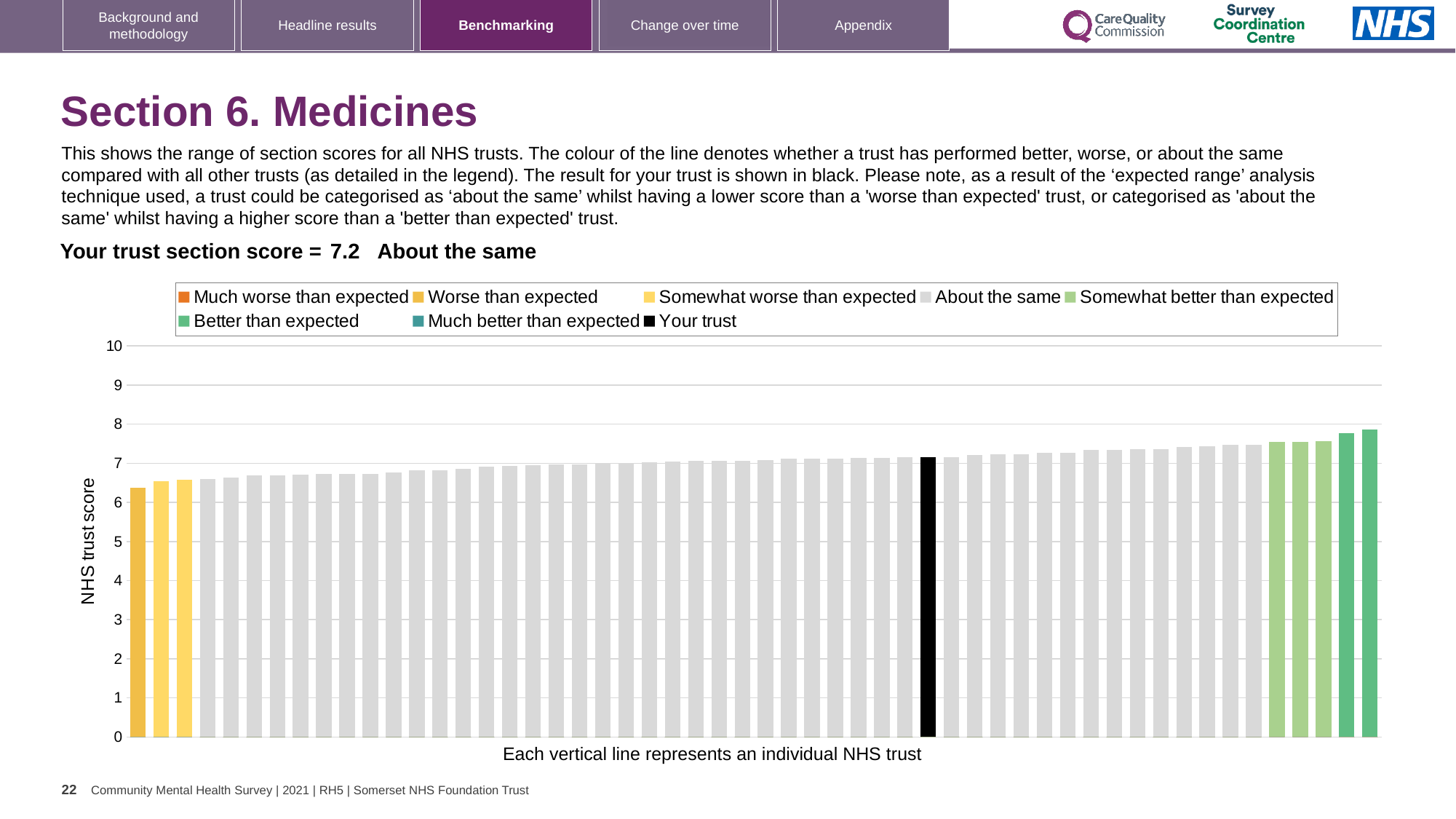
What is the highest value shown on the vertical axis? 10 Is the value of the black bar (your trust) greater or less than 7? greater What colour is the bar representing your trust? black What is the section score for your trust shown on the slide? 7.2 Is the value of the rightmost bar greater or less than 7? greater Is the value of the leftmost bar greater or less than 6? greater Which category is your trust placed in for the Medicines section? About the same How many entries does the chart legend list? 8 What kind of chart is shown on the slide? bar chart Do the bar values rise or fall from left to right along the x axis? rise What is the label on the vertical axis of the chart? NHS trust score